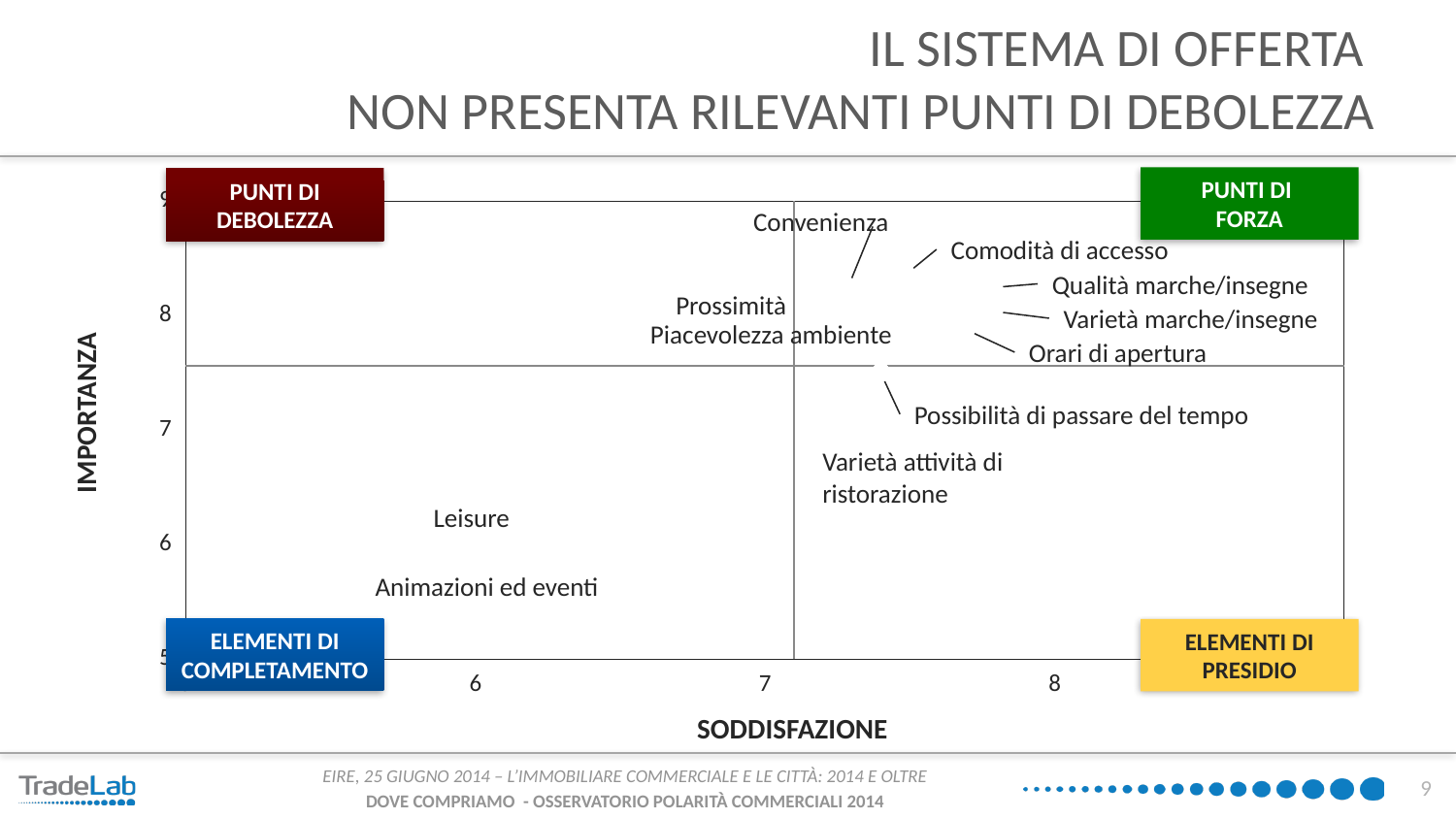
Is the importance value for Animazioni ed eventi greater or less than 7? less What is the label of the vertical axis of the chart? IMPORTANZA Is the importance value for Leisure greater or less than 7? less Which has the higher importance value, Leisure or Prossimità? Prossimità Is the satisfaction value for Leisure greater or less than 7? less Which labelled point has the lowest importance value? Animazioni ed eventi What kind of chart is shown on the slide? scatter chart How many labelled points are plotted on the chart? 11 What is the label of the horizontal axis of the chart? SODDISFAZIONE